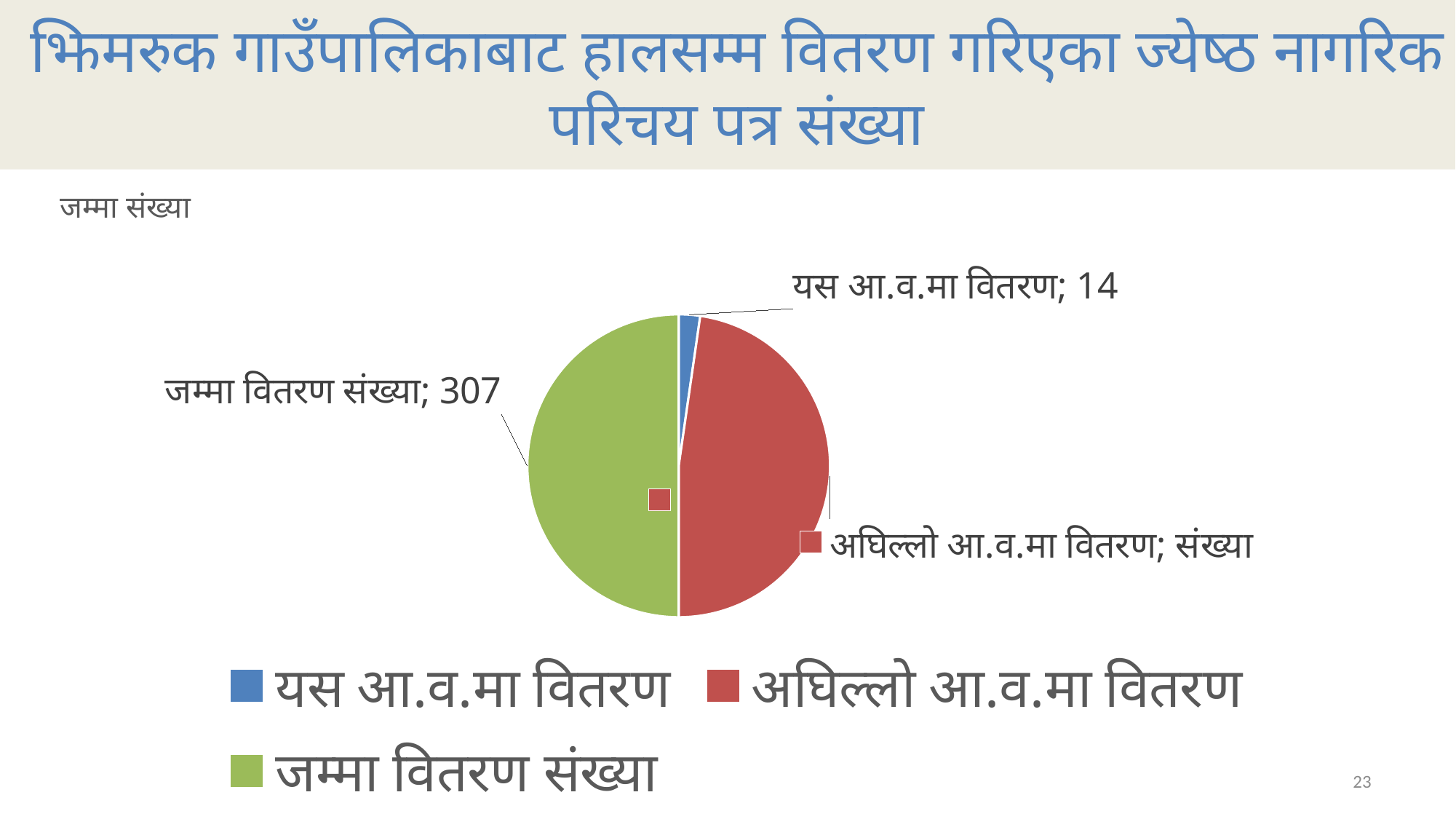
How many entries does the legend of the pie chart list? 3 What is the value shown for जम्मा वितरण संख्या in the pie chart? 307 What kind of chart is shown on the slide? pie chart What is the value shown for यस आ.व.मा वितरण in the pie chart? 14 Which slice is larger, अघिल्लो आ.व.मा वितरण or यस आ.व.मा वितरण? अघिल्लो आ.व.मा वितरण How many slices does the pie chart have? 3 Which slice of the pie chart is the smallest? यस आ.व.मा वितरण What is the difference between the values for जम्मा वितरण संख्या and यस आ.व.मा वितरण? 293 Which is larger, the value for जम्मा वितरण संख्या or the value for यस आ.व.मा वितरण? जम्मा वितरण संख्या What is the title of the pie chart? जम्मा संख्या What colour is the slice for यस आ.व.मा वितरण in the pie chart? blue